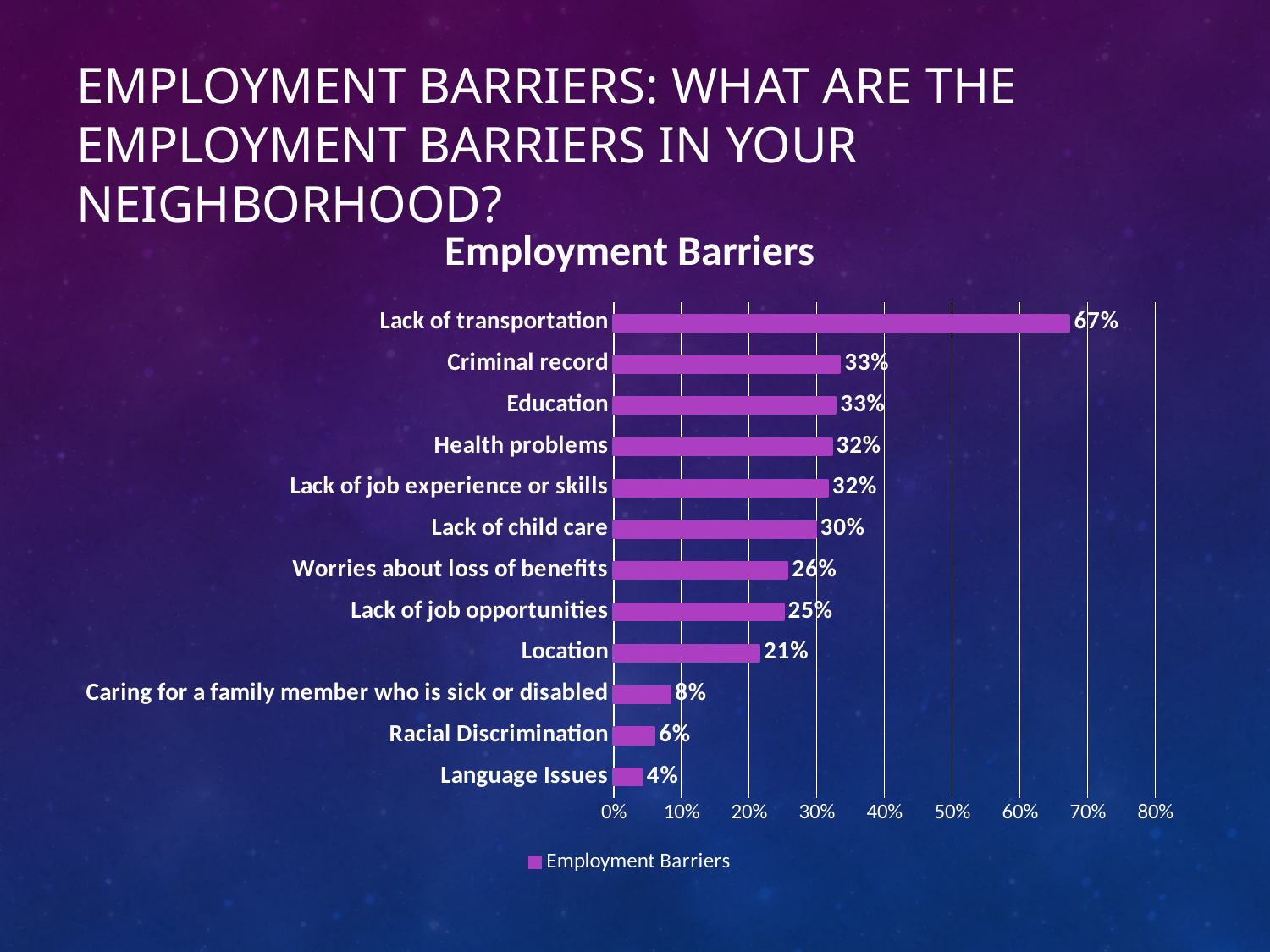
Which employment barrier has the lowest percentage? Language Issues What is the difference between the values for Lack of transportation and Criminal record? 34% What kind of chart is shown on the slide? Bar chart What percentage is shown for Racial Discrimination? 6% Which employment barrier has the highest percentage? Lack of transportation Which is larger, the value for Location or the value for Lack of job opportunities? Lack of job opportunities How many series does the legend list? 1 How many employment barriers are listed in the chart? 12 What is the value for Lack of child care? 30% What percentage is shown for Lack of transportation? 67% Is the value for Worries about loss of benefits greater or less than 30%? less What is the title of the chart? Employment Barriers